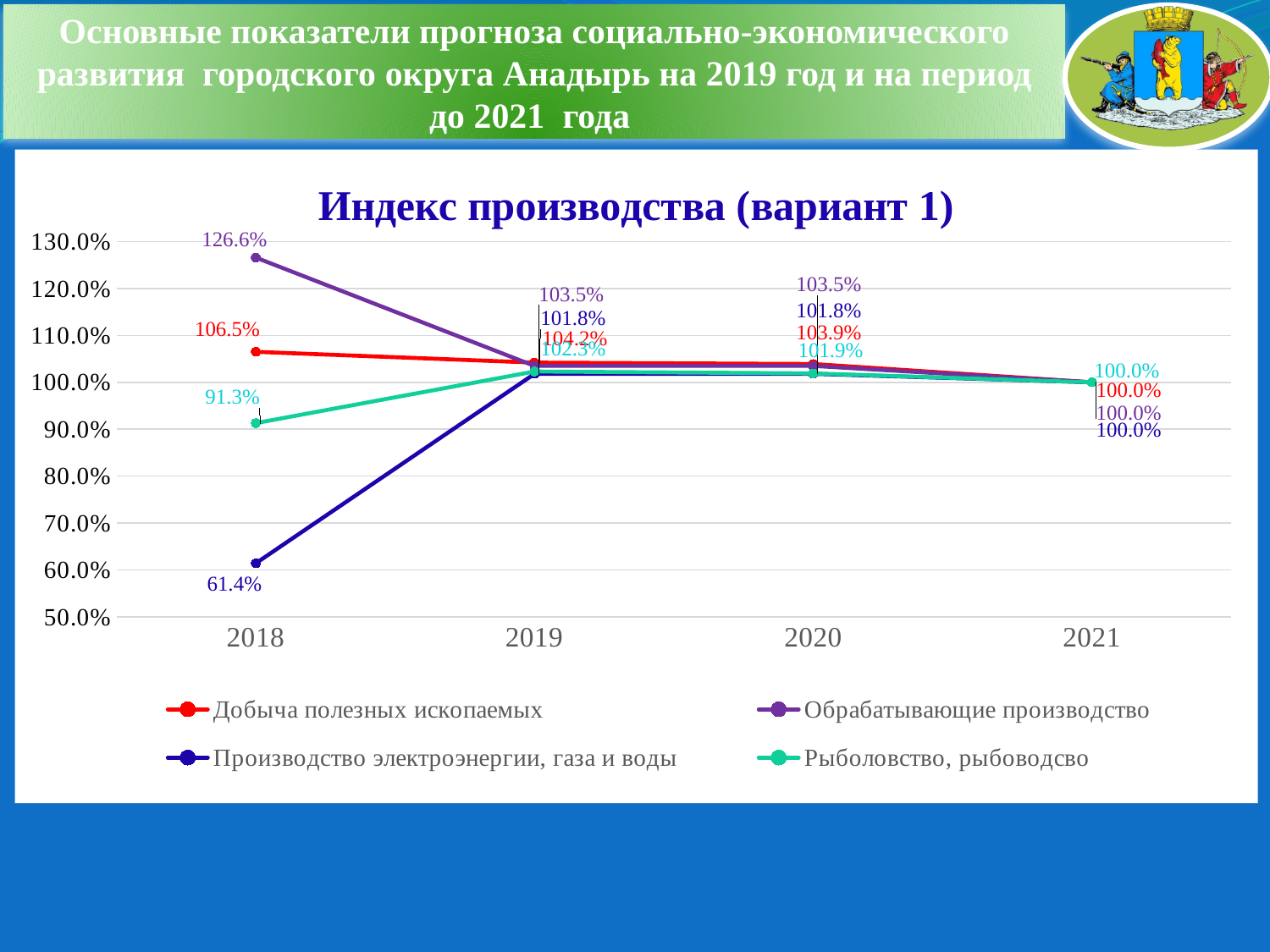
What type of chart is shown on the slide? Line chart What is the value for Обрабатывающие производство in 2018? 126.6% What is the value for Рыболовство, рыбоводсво in 2018? 91.3% Which series has the lowest value in 2018? Производство электроэнергии, газа и воды What is the difference between the highest and lowest values in 2018? 65.2 percentage points What is the value for Производство электроэнергии, газа и воды in 2018? 61.4% How many series does the legend list? 4 Which series has the highest value in 2018? Обрабатывающие производство What value do all four series reach in 2021? 100.0% How many years are shown on the x axis? 4 What is the value for Добыча полезных ископаемых in 2018? 106.5% Does the value for Производство электроэнергии, газа и воды rise or fall from 2018 to 2019? Rise